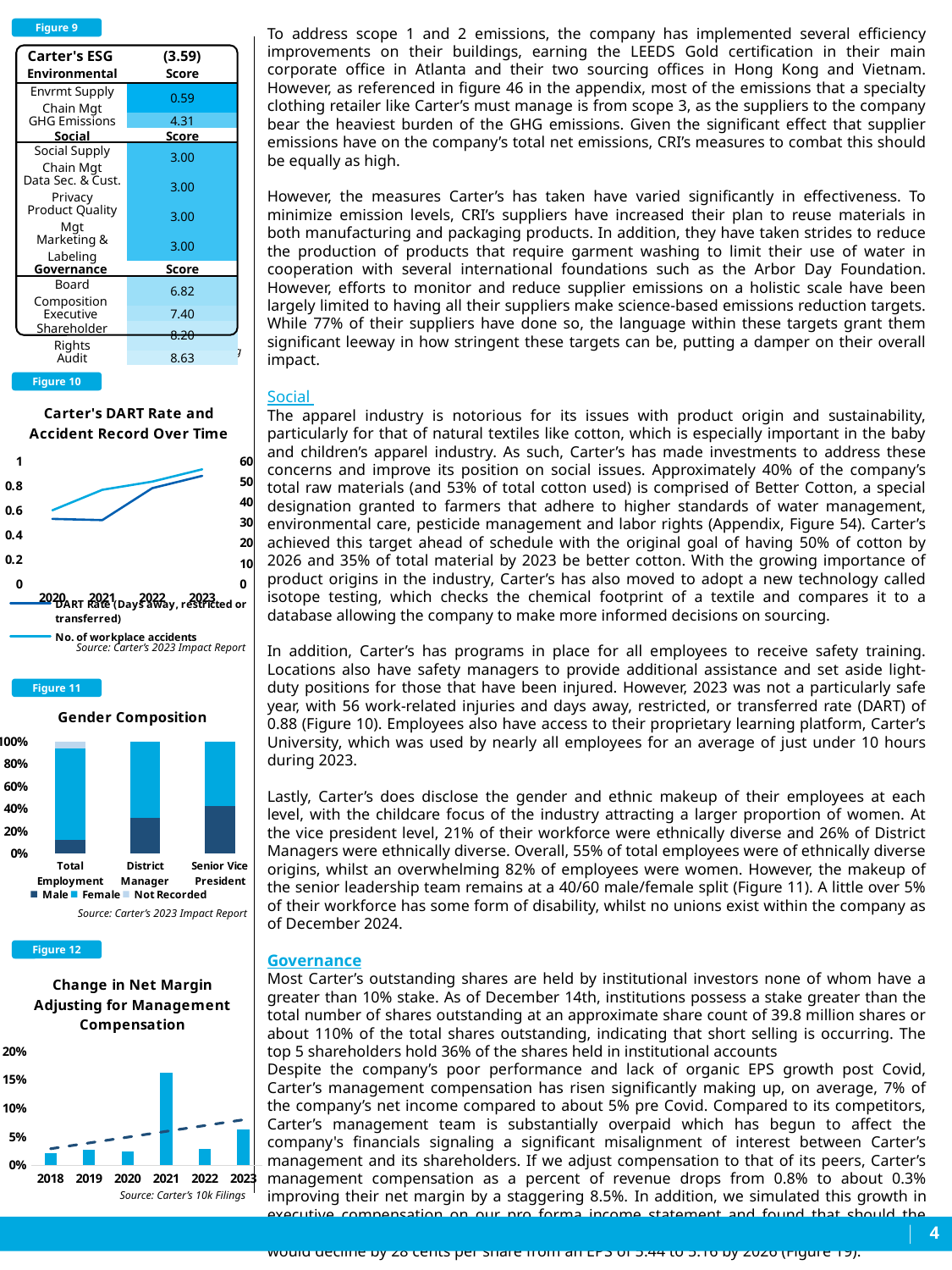
How many years are shown on the x axis of Figure 12? 6 What kind of chart is Figure 11, 'Gender Composition'? bar chart What kind of chart is Figure 10, 'Carter's DART Rate and Accident Record Over Time'? line chart In Figure 12, is the value for 2018 greater or less than 5%? less In Figure 12, 'Change in Net Margin Adjusting for Management Compensation', which year has the highest bar? 2021 How many years are shown on the x axis of Figure 10? 4 How many series does the legend of Figure 11 list? 3 In Figure 11, which category has the larger Male share: Total Employment or Senior Vice President? Senior Vice President How many series does the legend of Figure 10 list? 2 In Figure 10, does the number of workplace accidents rise or fall from 2020 to 2023? rise In Figure 10, is the number of workplace accidents in 2023 greater or less than 50? greater In Figure 11, is the Male share for Senior Vice President greater or less than 20%? greater